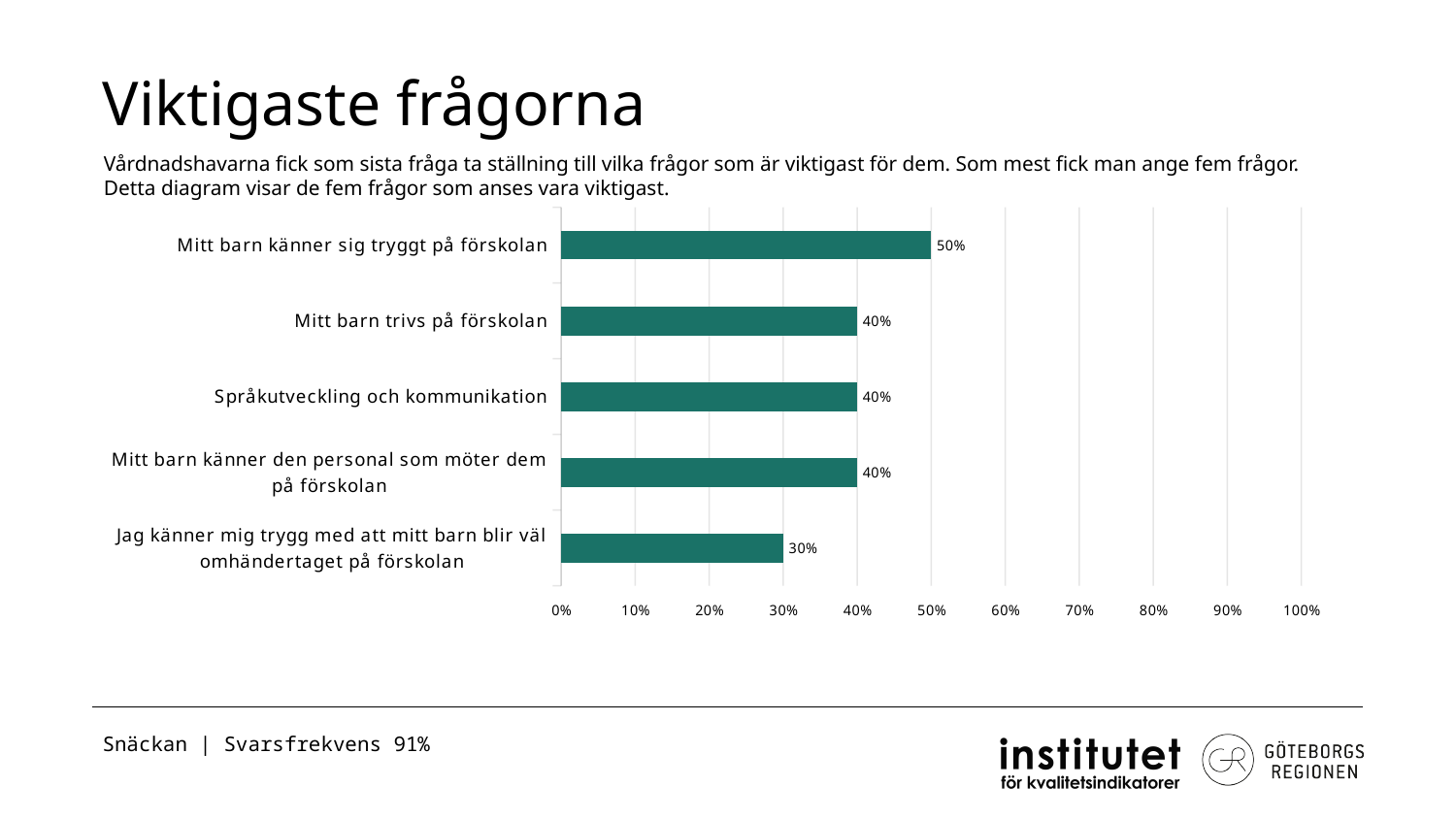
What kind of chart is shown on the slide? bar chart Which category has the highest value? Mitt barn känner sig tryggt på förskolan Is the value for "Mitt barn känner den personal som möter dem på förskolan" greater or less than 60%? less What is the value for "Mitt barn känner sig tryggt på förskolan"? 50% What is the value for "Språkutveckling och kommunikation"? 40% Which category has the lowest value? Jag känner mig trygg med att mitt barn blir väl omhändertaget på förskolan What is the value for "Jag känner mig trygg med att mitt barn blir väl omhändertaget på förskolan"? 30% What is the difference between the highest and lowest values in the chart? 20% How many categories are shown in the chart? 5 What is the title of the slide? Viktigaste frågorna What is the difference between the values for "Mitt barn känner sig tryggt på förskolan" and "Mitt barn trivs på förskolan"? 10% Which is larger: the value for "Mitt barn trivs på förskolan" or the value for "Jag känner mig trygg med att mitt barn blir väl omhändertaget på förskolan"? Mitt barn trivs på förskolan